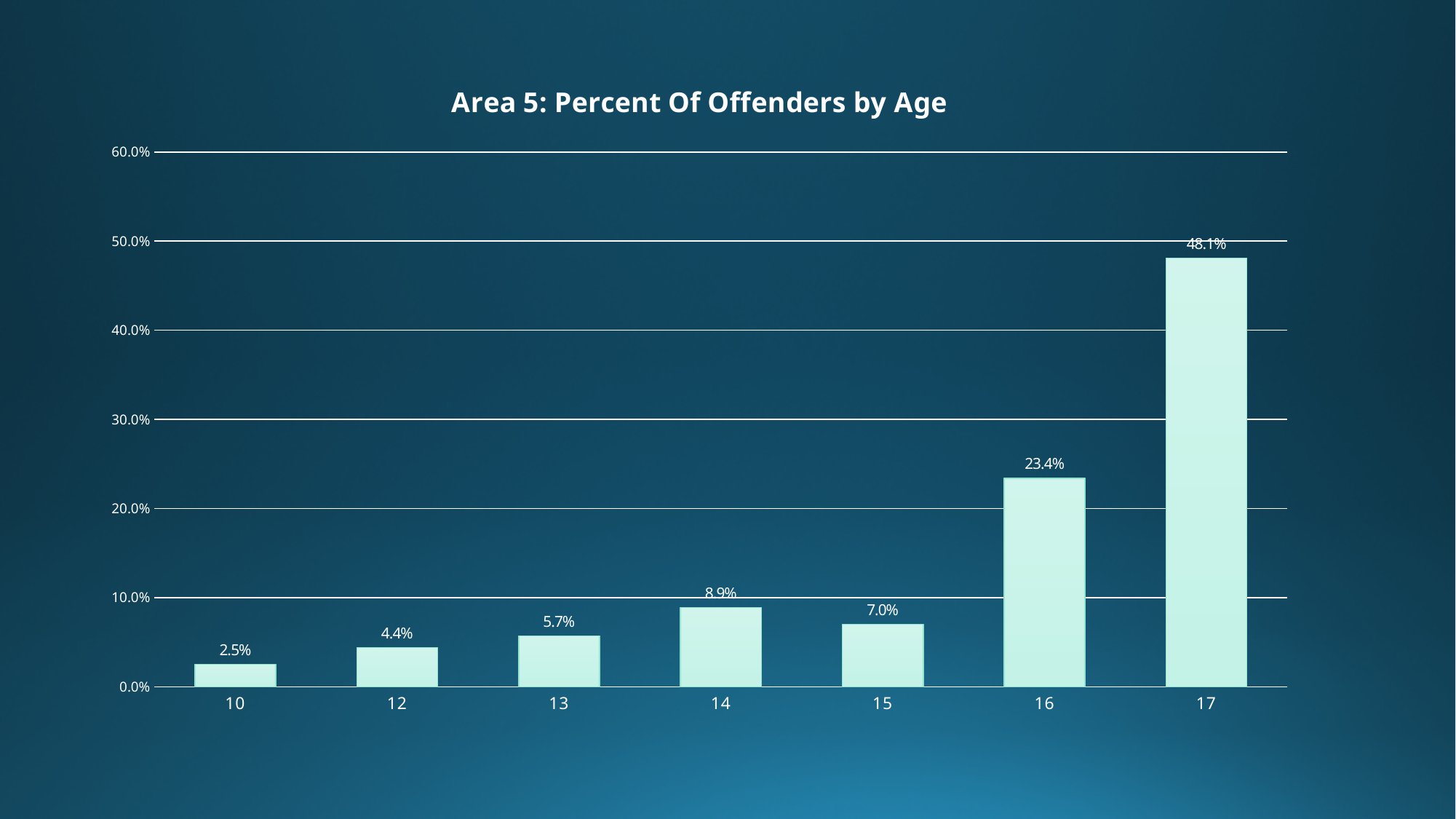
What is the percent of offenders for age 12? 4.4% Which age has the highest percent of offenders? 17 How many age categories are shown on the chart? 7 Which has a higher percent of offenders, age 14 or age 15? 14 Which age has the lowest percent of offenders? 10 What is the percent of offenders for age 17? 48.1% What is the title of the chart? Area 5: Percent Of Offenders by Age What kind of chart is shown on the slide? Bar chart Is the value for age 16 greater or less than 20.0%? greater What is the difference between the percent of offenders for age 17 and age 16? 24.7% What is the percent of offenders for age 15? 7.0% What is the difference between the percent of offenders for age 14 and age 13? 3.2%